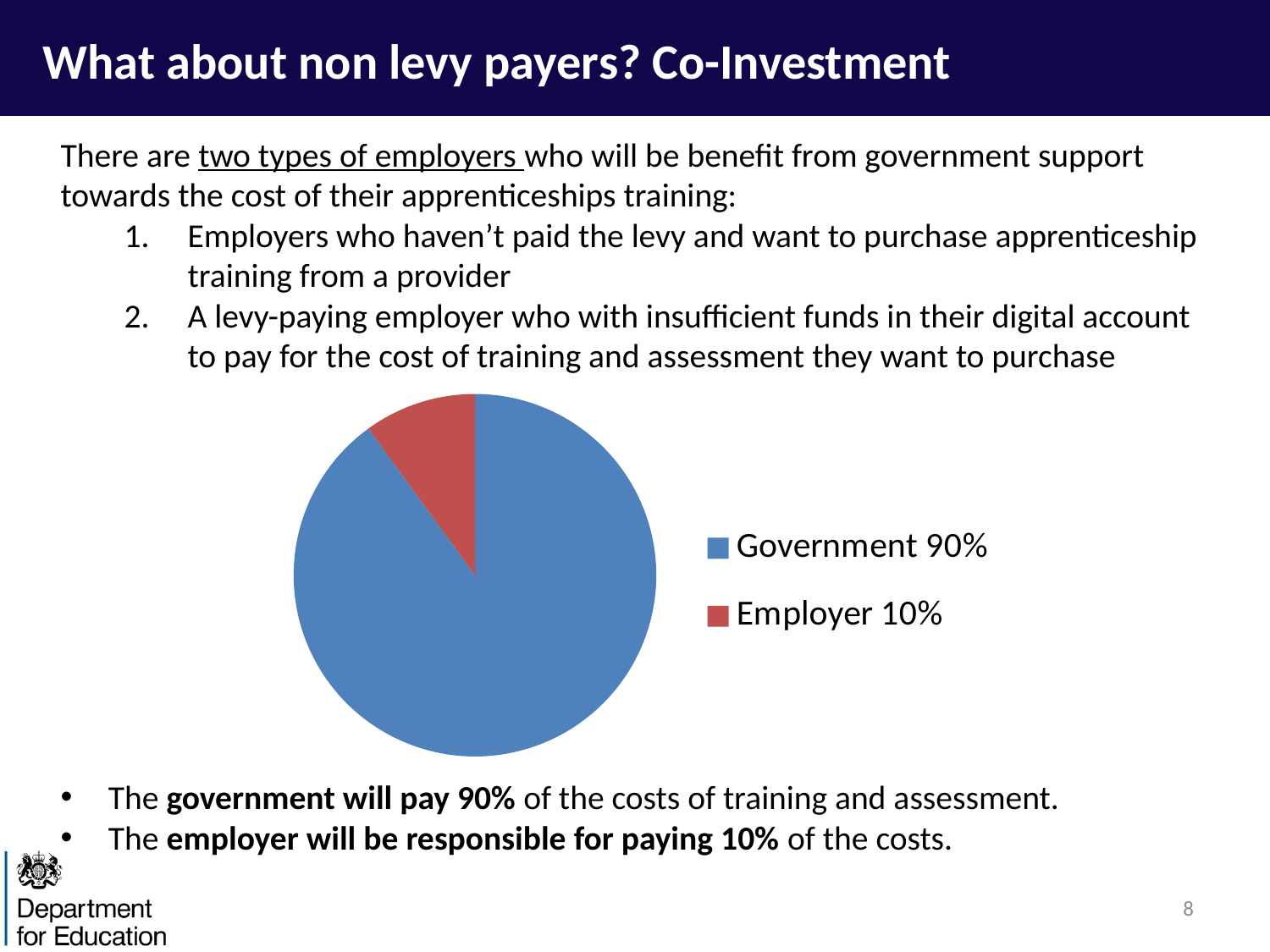
How many slices does the pie chart have? 2 What kind of chart is shown on the slide? pie chart Which slice of the pie chart is the largest? Government What share of the pie does the Government slice represent? 90% What colour is the Employer slice in the pie chart? red Which is larger in the pie chart, the Government share or the Employer share? Government How many entries does the legend of the pie chart list? 2 Which slice of the pie chart is the smallest? Employer What colour is the Government slice in the pie chart? blue What share of the pie does the Employer slice represent? 10% What is the difference between the Government share and the Employer share in the pie chart? 80%